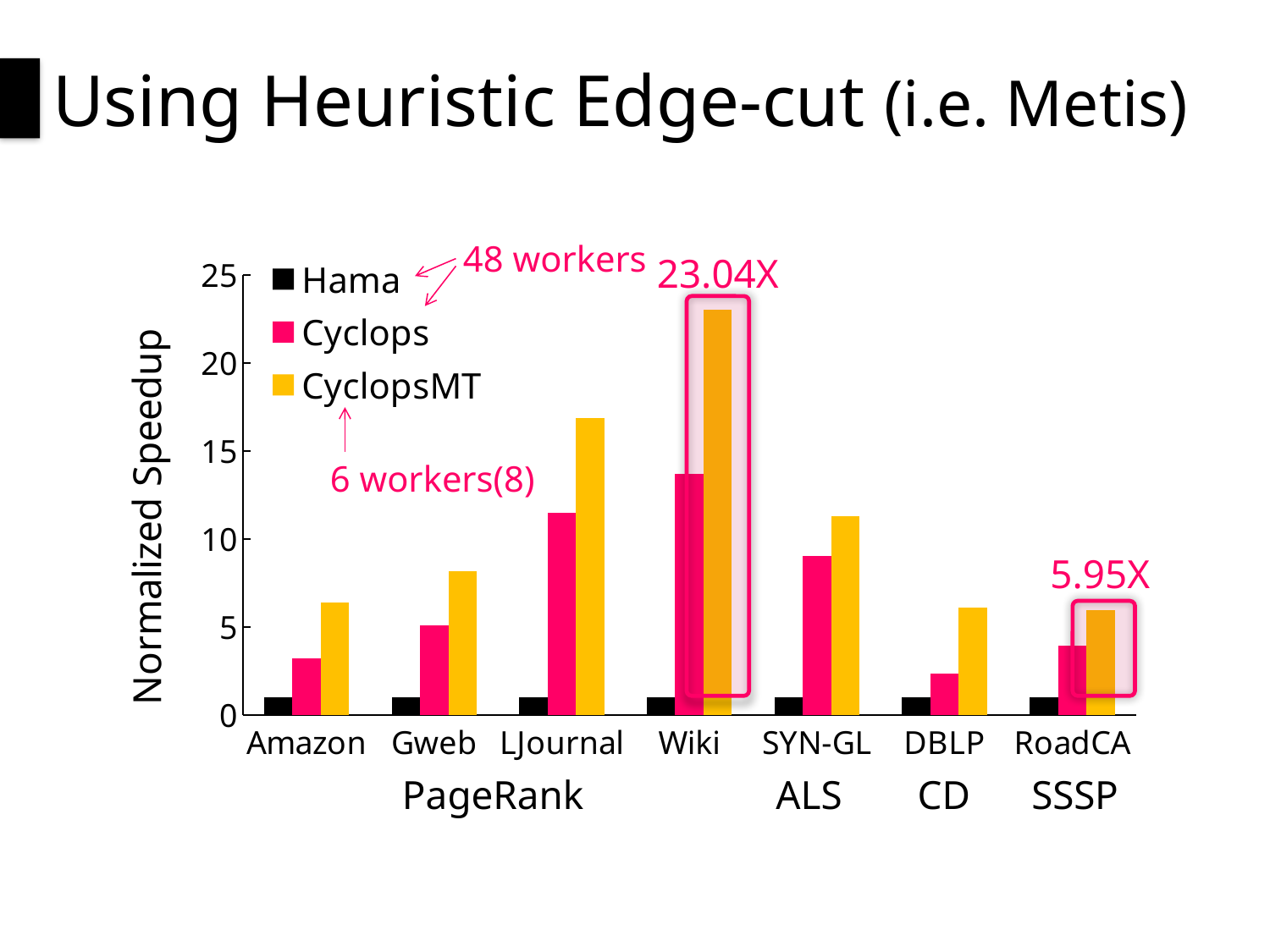
Which dataset has the highest CyclopsMT speedup? Wiki What is the difference between the CyclopsMT speedup on Wiki and on RoadCA? 17.09X Is the Cyclops value for Amazon greater or less than 5? less What kind of chart is shown on the slide? bar chart How many series does the legend list? 3 What is the label of the y axis? Normalized Speedup How many datasets (categories) are shown along the x axis? 7 Which dataset has the lowest Cyclops speedup? DBLP For LJournal, which is larger: the Cyclops bar or the CyclopsMT bar? CyclopsMT What is the normalized speedup of CyclopsMT on Wiki? 23.04X What is the normalized speedup of CyclopsMT on RoadCA? 5.95X Is the CyclopsMT value for LJournal greater or less than 15? greater